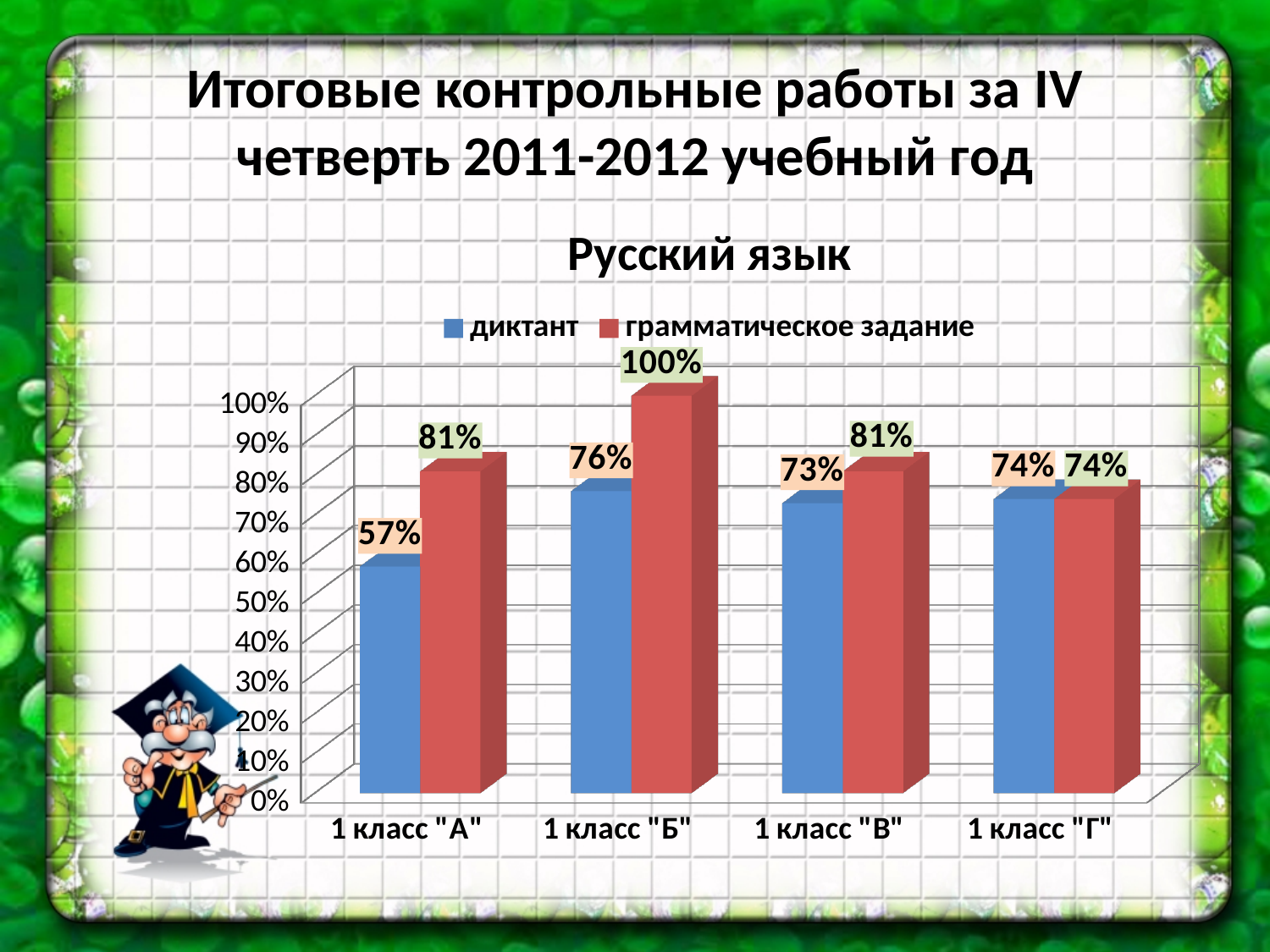
Which class has the lowest диктант value? 1 класс "А" What is the диктант value for 1 класс "А"? 57% Which class has the highest грамматическое задание value? 1 класс "Б" What is the difference between the грамматическое задание and диктант values for 1 класс "А"? 24% How many classes are shown on the x axis? 4 Which is larger for 1 класс "Б": диктант or грамматическое задание? грамматическое задание What kind of chart is shown? bar chart Is the диктант value for 1 класс "А" greater or less than 60%? less What is the диктант value for 1 класс "В"? 73% What is the title of the chart? Русский язык How many series does the legend list? 2 What is the грамматическое задание value for 1 класс "Б"? 100%